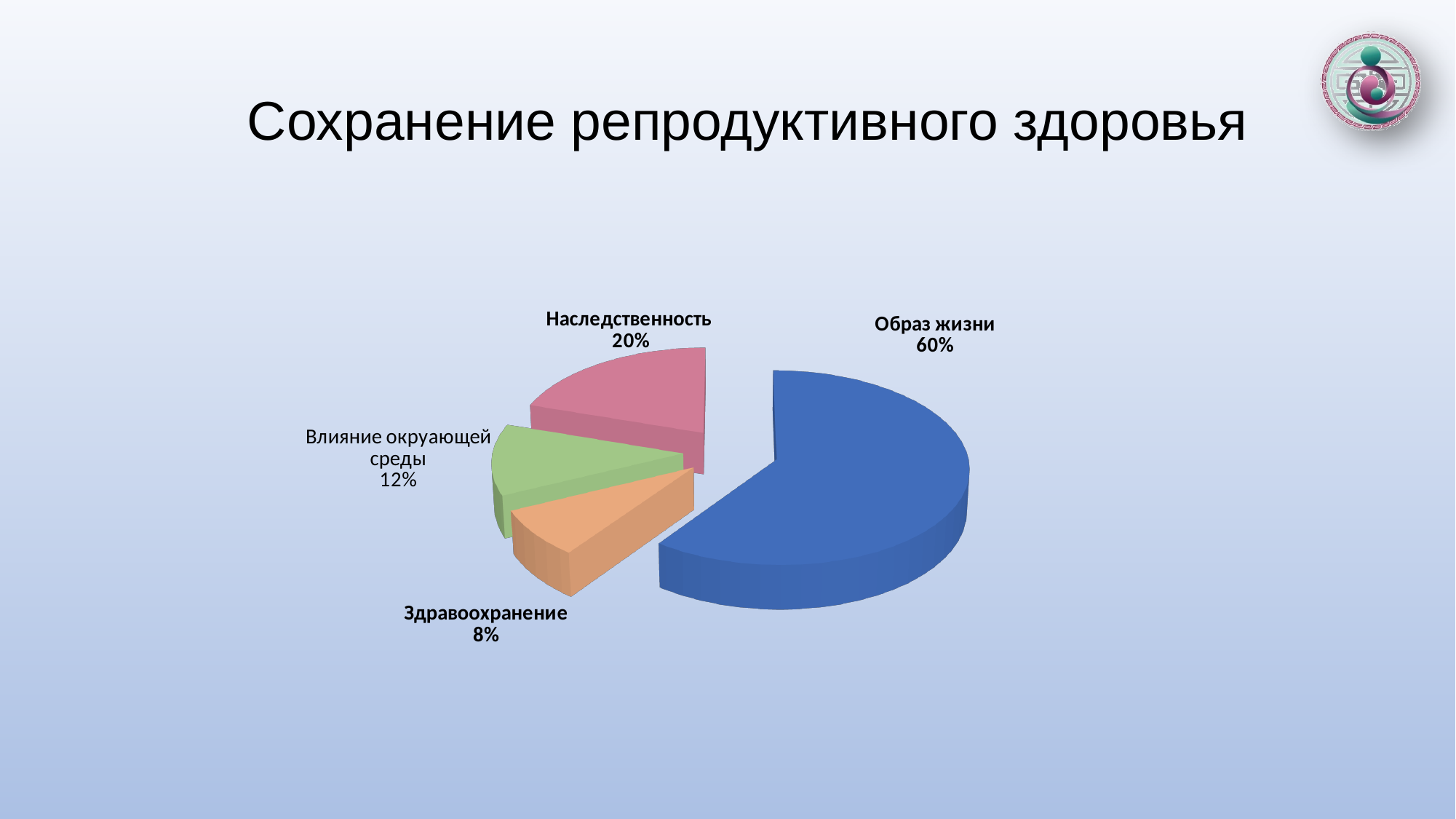
What kind of chart is shown on the slide? pie chart What share of the pie does Наследственность have? 20% What is the difference in percentage points between Образ жизни and Наследственность? 40 What is the difference in percentage points between Влияние окруающей среды and Здравоохранение? 4 How many slices does the pie chart have? 4 What share of the pie does Здравоохранение have? 8% Which is larger, Наследственность or Влияние окруающей среды? Наследственность What share of the pie does Влияние окруающей среды have? 12% Which slice of the pie is the largest? Образ жизни What colour is the Образ жизни slice? blue Which slice of the pie is the smallest? Здравоохранение